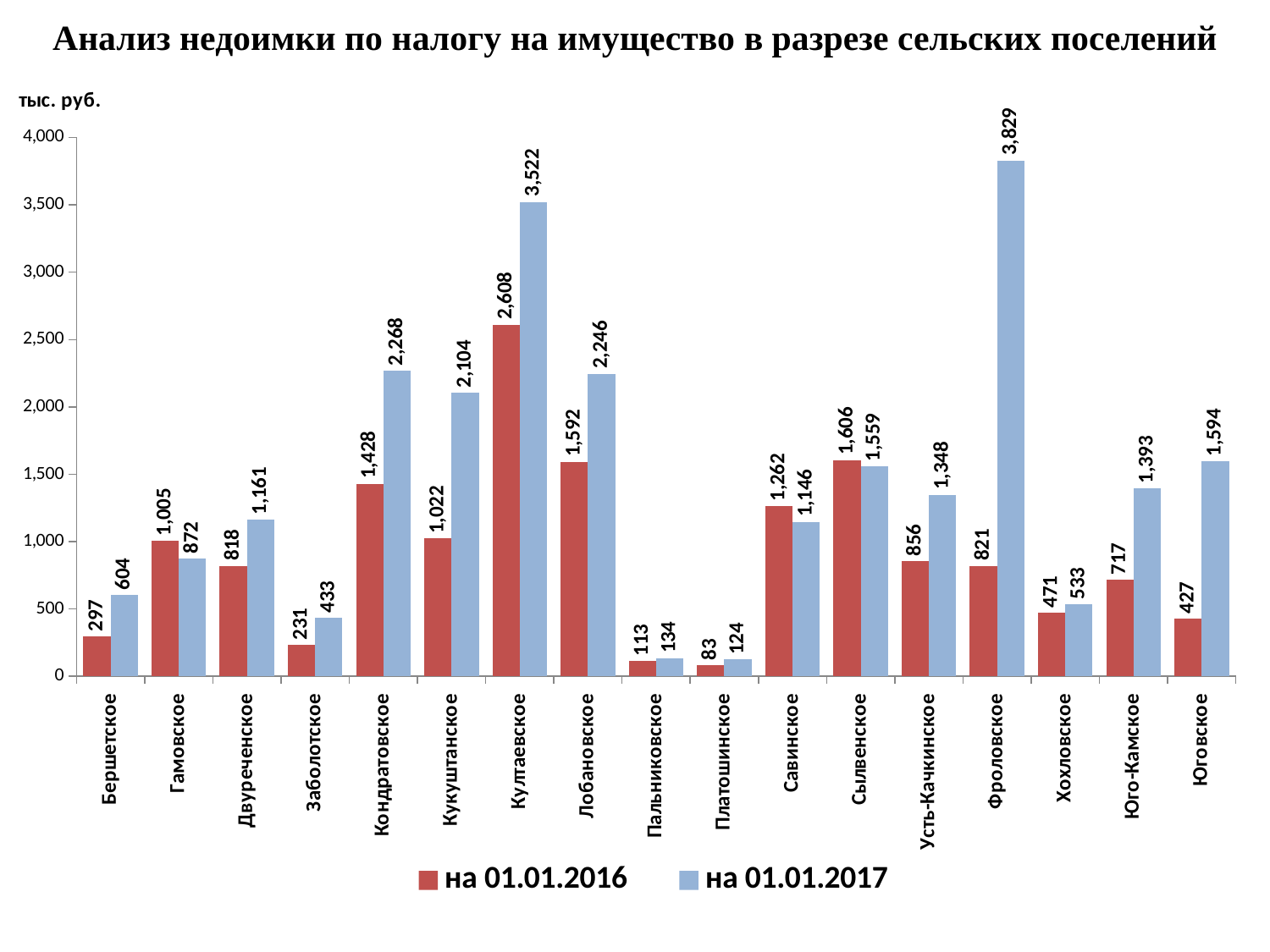
What is the value for Култаевское in the series на 01.01.2016? 2,608 How many series does the legend list? 2 Which settlement has the highest value in the series на 01.01.2017? Фроловское Which settlement has the highest value in the series на 01.01.2016? Култаевское Which settlement has the lowest value in the series на 01.01.2016? Платошинское What is the difference between the на 01.01.2017 and на 01.01.2016 values for Фроловское? 3,008 How many settlements are shown on the x axis? 17 What kind of chart is shown on the slide? Bar chart What is the value for Фроловское in the series на 01.01.2017? 3,829 What is the value for Заболотское in the series на 01.01.2017? 433 What is the difference between the на 01.01.2017 and на 01.01.2016 values for Кондратовское? 840 For Савинское, which series has the larger value, на 01.01.2016 or на 01.01.2017? на 01.01.2016